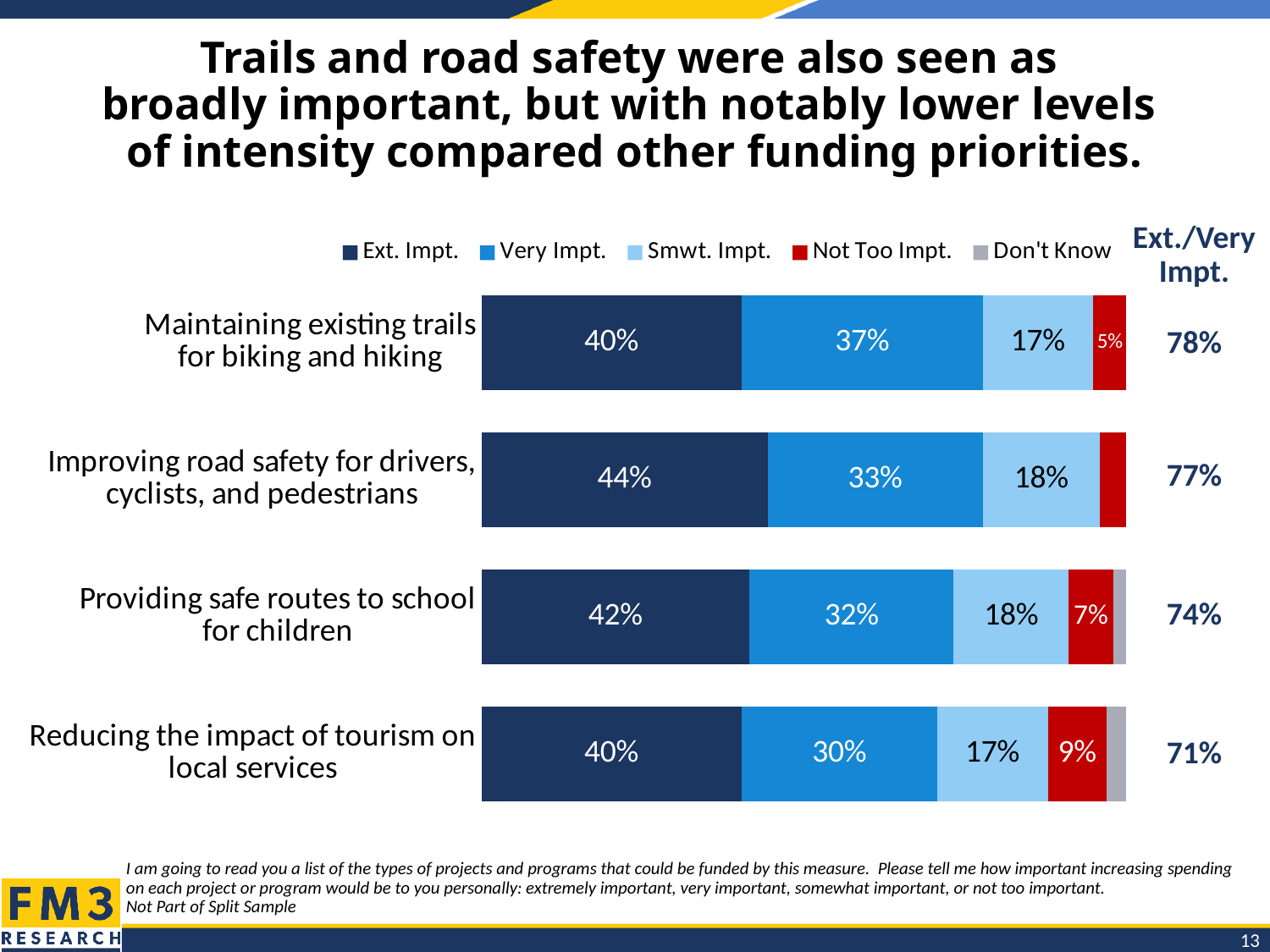
Which category has the lowest Ext./Very Impt. combined value? Reducing the impact of tourism on local services Which category has the highest Ext. Impt. value? Improving road safety for drivers, cyclists, and pedestrians Which is larger: the Not Too Impt. value for "Providing safe routes to school for children" or for "Reducing the impact of tourism on local services"? Reducing the impact of tourism on local services How many categories (funding priorities) are plotted in the chart? 4 How many series does the legend list? 5 What is the Not Too Impt. value for "Providing safe routes to school for children"? 7% What is the Very Impt. value for "Reducing the impact of tourism on local services"? 30% What is the difference between the Very Impt. values for "Maintaining existing trails for biking and hiking" and "Reducing the impact of tourism on local services"? 7% What is the Ext./Very Impt. combined value shown for "Providing safe routes to school for children"? 74% What is the Smwt. Impt. value for "Maintaining existing trails for biking and hiking"? 17% What is the Ext. Impt. value for "Improving road safety for drivers, cyclists, and pedestrians"? 44% What kind of chart is shown on the slide? Stacked bar chart